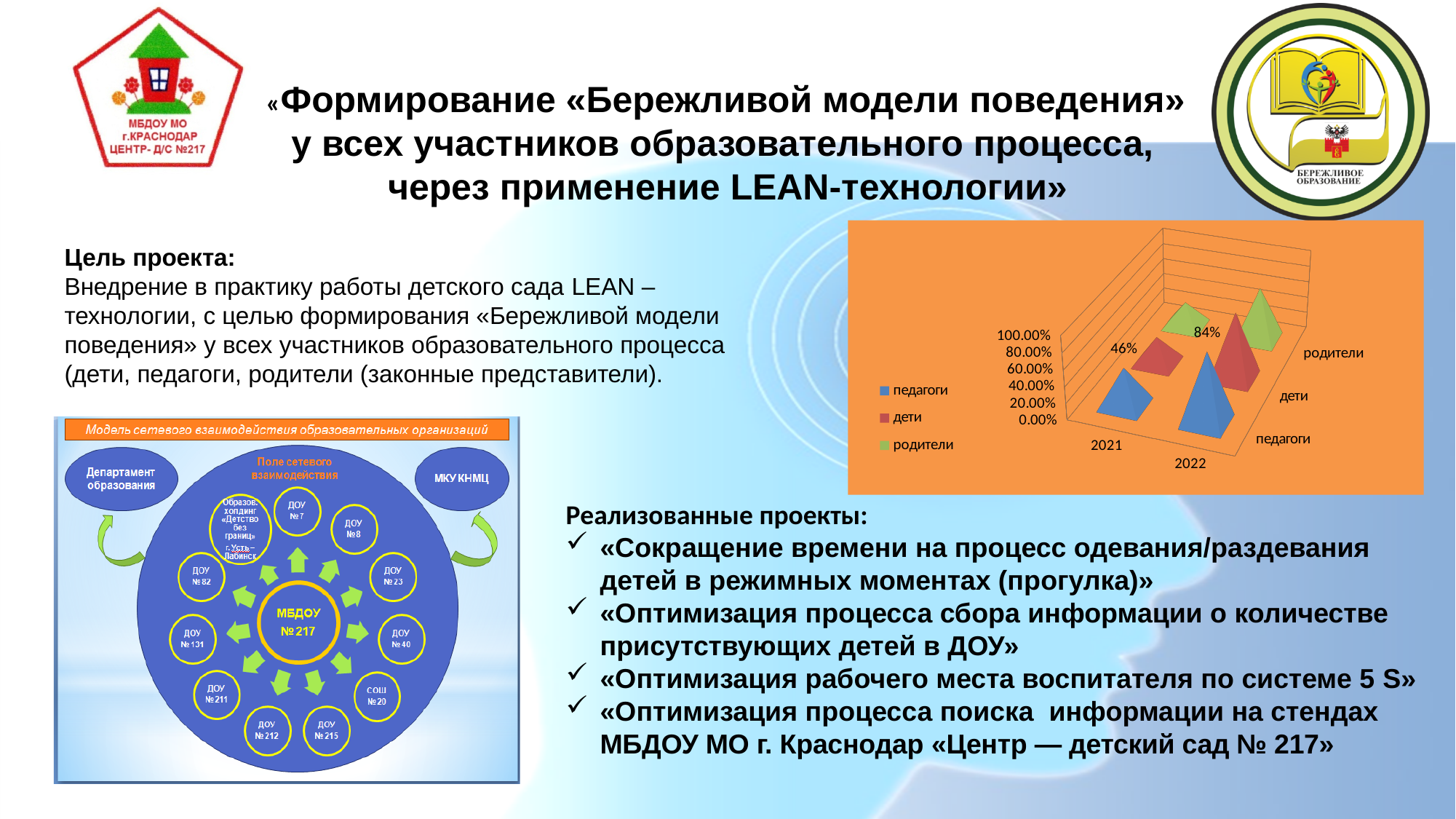
Which two data labels are printed on the chart? 46% and 84% For дети, which year has the larger value, 2021 or 2022? 2022 What is the highest value shown on the vertical axis of the chart? 100.00% How many year categories are shown along the horizontal axis of the chart? 2 What are the legend entries of the chart? педагоги, дети, родители What kind of chart is shown on the slide? 3D bar chart What is the lowest tick shown on the vertical axis of the chart? 0.00% Which years are shown as categories on the chart? 2021 and 2022 Does the value for педагоги rise or fall from 2021 to 2022? rise For педагоги, which year has the larger value, 2021 or 2022? 2022 For родители, which year has the larger value, 2021 or 2022? 2022 How many series does the legend of the chart list? 3